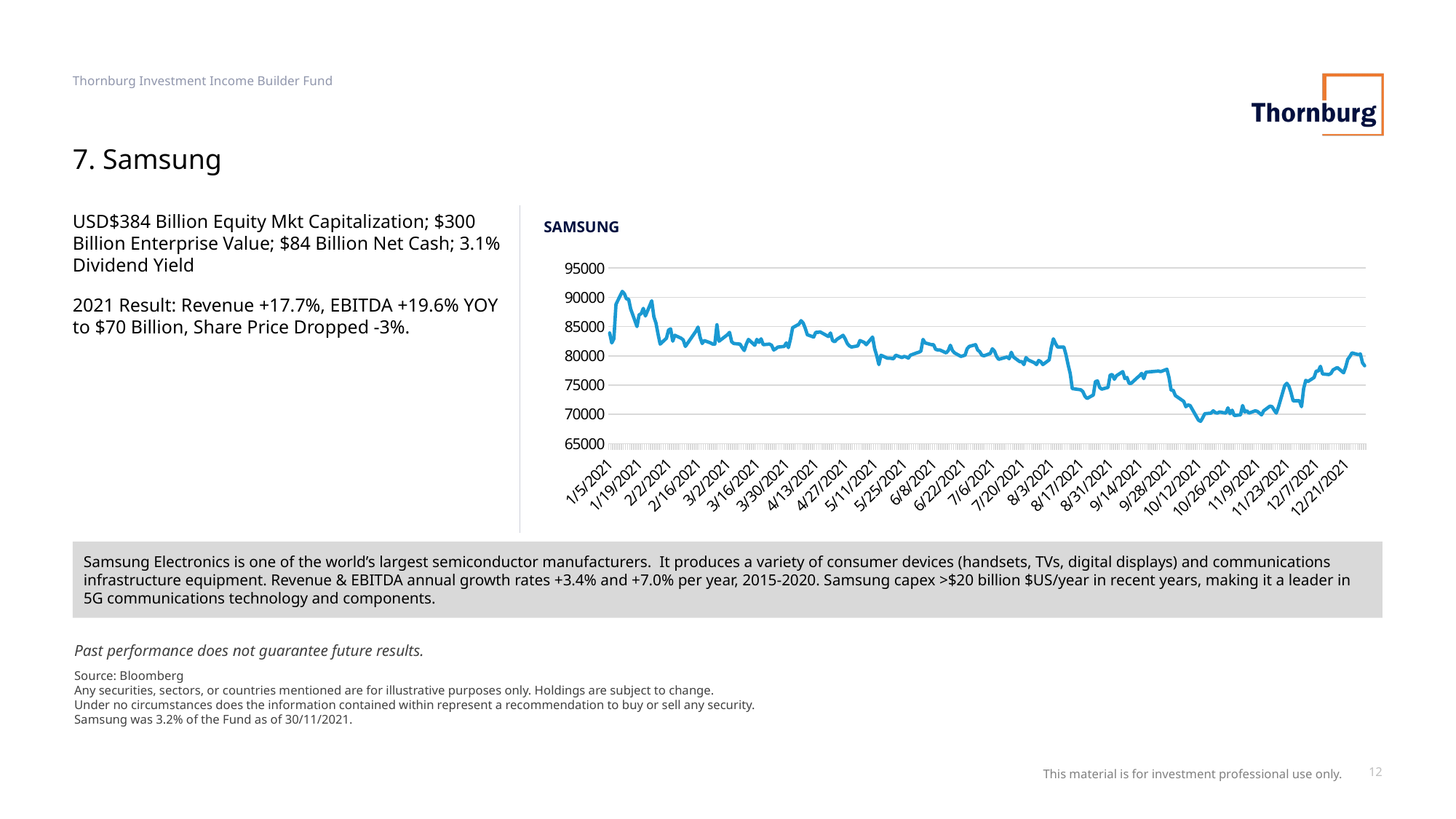
Is the value around 1/19/2021 greater or less than 85000? greater In which month does the line reach its lowest point? October What kind of chart is shown on the slide? line chart Which is higher, the value around 1/19/2021 or the value around 10/12/2021? 1/19/2021 Is the value around 5/11/2021 greater or less than 85000? less What is the title of the chart? SAMSUNG Is the value around 10/12/2021 greater or less than 75000? less How many lines (series) are plotted on the chart? 1 What is the highest value shown on the vertical axis? 95000 In which month does the line reach its highest point? January Overall, does the plotted value rise or fall from the start of the chart (1/5/2021) to the end (12/21/2021)? fall